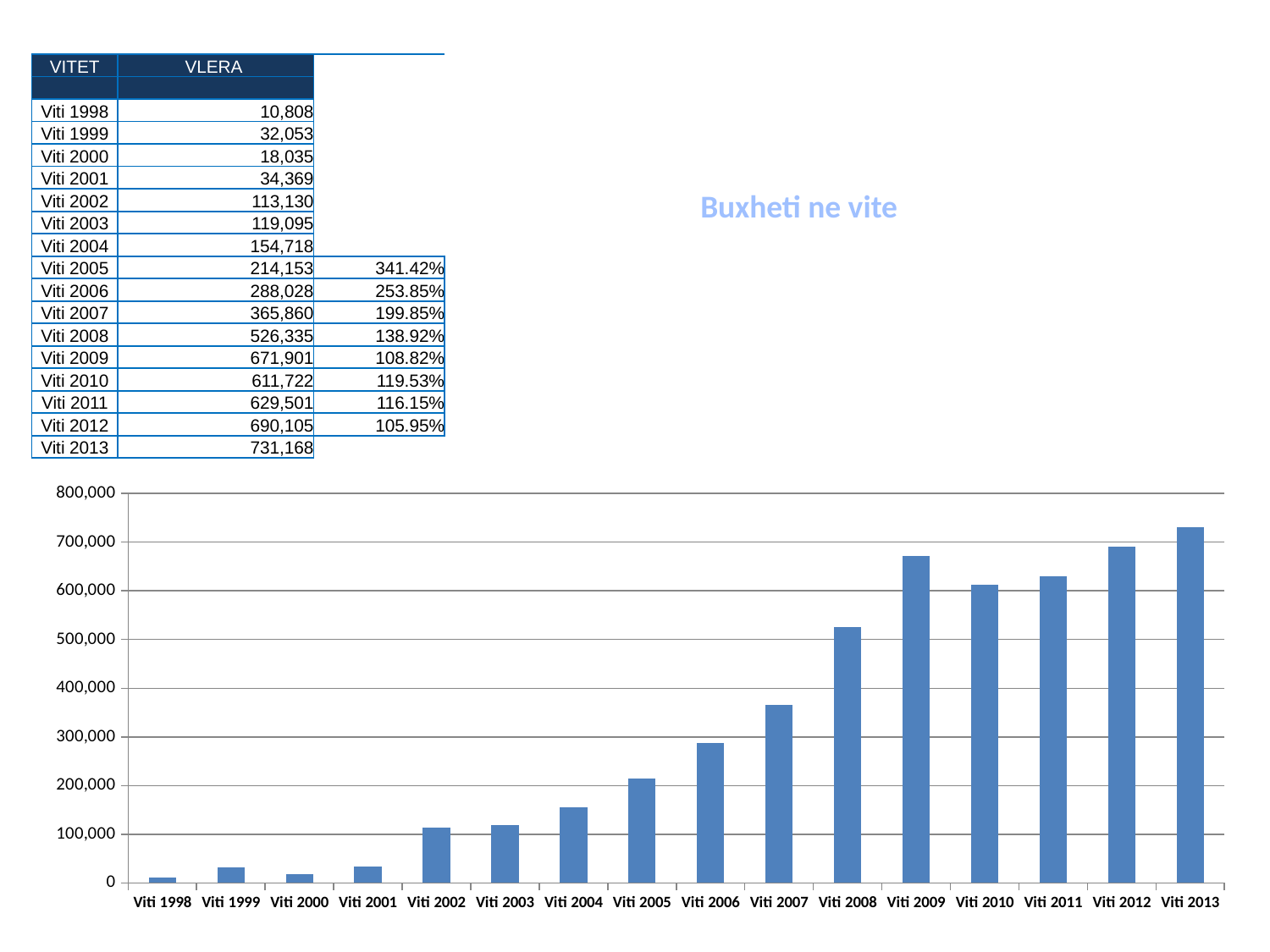
What kind of chart is shown on the slide? bar chart Which is larger, the value for Viti 2009 or the value for Viti 2010? Viti 2009 According to the table on the slide, what is the value for Viti 2013? 731,168 Is the value for Viti 2007 greater or less than 400,000? less Which year has the highest value in the chart? Viti 2013 How many years (bars) are plotted in the chart? 16 According to the table on the slide, what is the value for Viti 2002? 113,130 Which year has the lowest value in the chart? Viti 1998 Is the value for Viti 2008 greater or less than 500,000? greater Do the values generally rise or fall from Viti 1998 to Viti 2013? rise Using the values in the table, what is the difference between Viti 2013 and Viti 2012? 41,063 What is the title of the chart? Buxheti ne vite